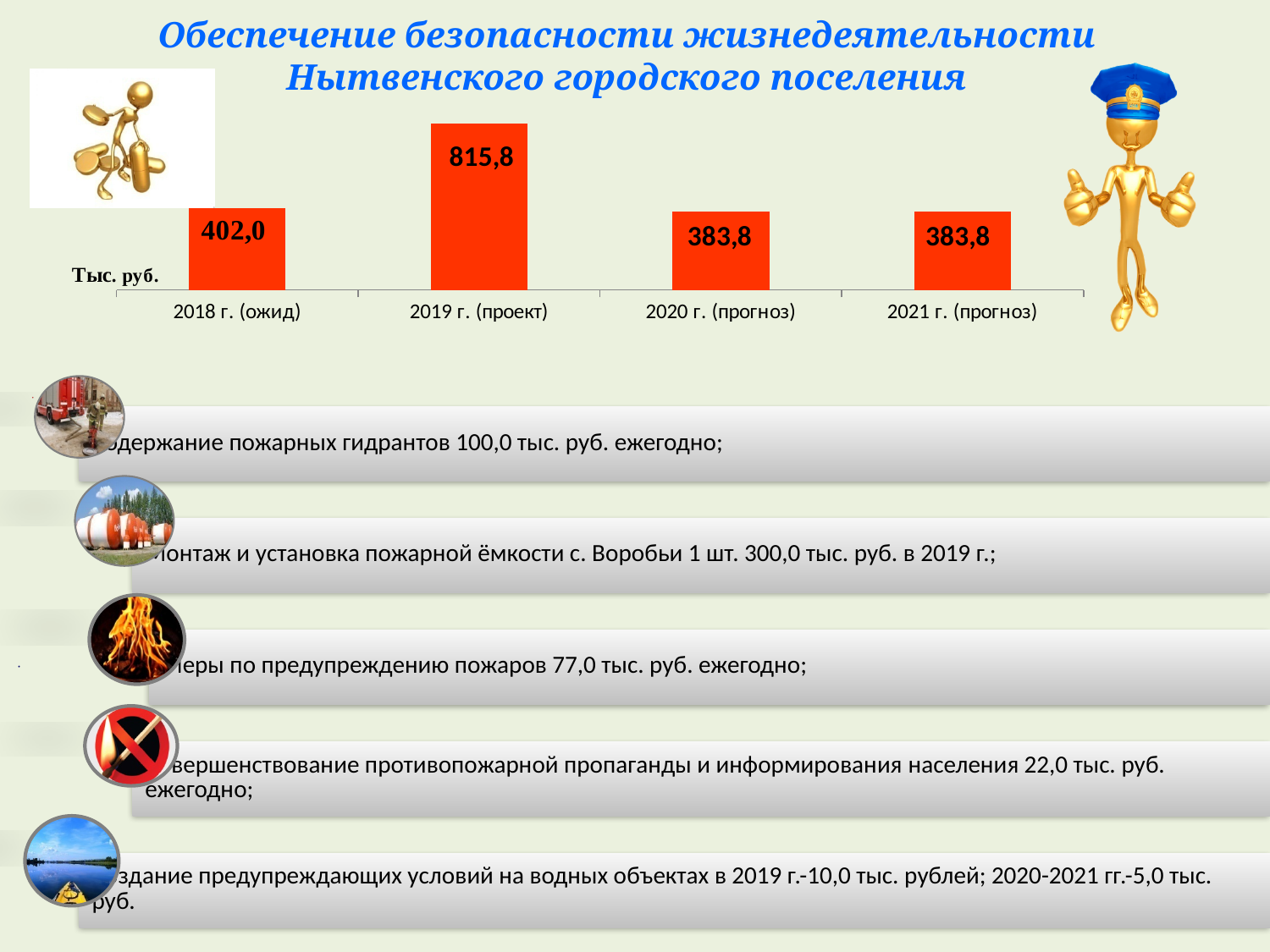
What is the difference between the values for 2018 г. (ожид) and 2020 г. (прогноз)? 18,2 What is the value for 2018 г. (ожид)? 402,0 What is the value for 2020 г. (прогноз)? 383,8 Do the values rise or fall from 2019 г. (проект) to 2020 г. (прогноз)? fall Which category has the highest value? 2019 г. (проект) Which is larger, the value for 2018 г. (ожид) or the value for 2021 г. (прогноз)? 2018 г. (ожид) What is the value for 2019 г. (проект)? 815,8 What unit is indicated next to the chart's vertical axis? Тыс. руб. What is the difference between the values for 2019 г. (проект) and 2018 г. (ожид)? 413,8 What kind of chart is shown on the slide? bar chart What is the value for 2021 г. (прогноз)? 383,8 How many categories are shown on the x axis of the chart? 4